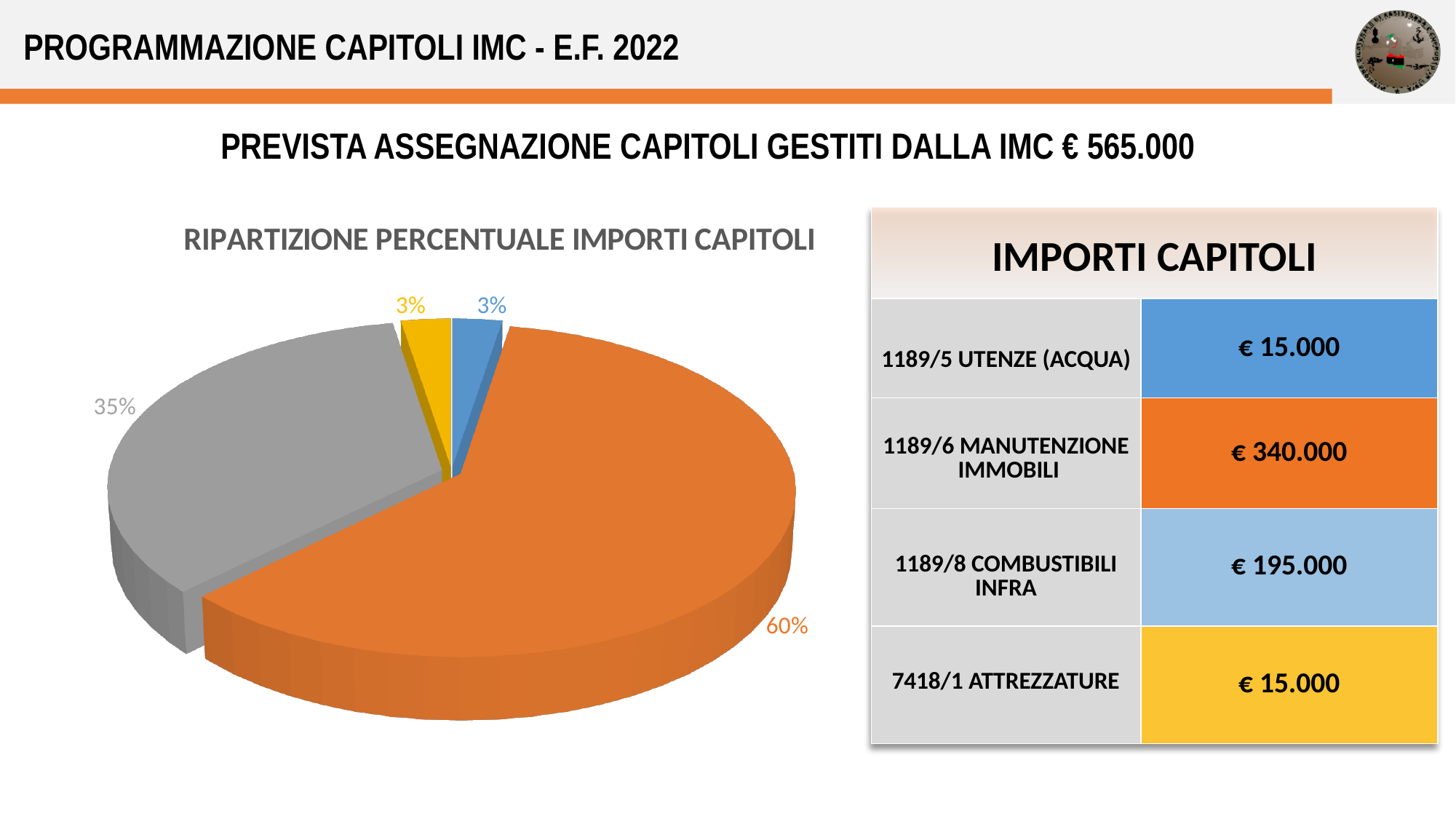
What colour is the largest slice of the pie chart? orange What is the title of the pie chart? RIPARTIZIONE PERCENTUALE IMPORTI CAPITOLI What is the largest share shown in the pie chart? 60% What percentage is shown for the yellow slice of the pie chart? 3% What percentage is shown for the orange slice of the pie chart? 60% What percentage is shown for the grey slice of the pie chart? 35% Which slice is larger in the pie chart, the orange one or the grey one? orange What is the smallest share shown in the pie chart? 3% What kind of chart is shown on the slide? pie chart What percentage is shown for the blue slice of the pie chart? 3% What is the difference between the orange slice and the grey slice in the pie chart? 25% How many slices does the pie chart have? 4